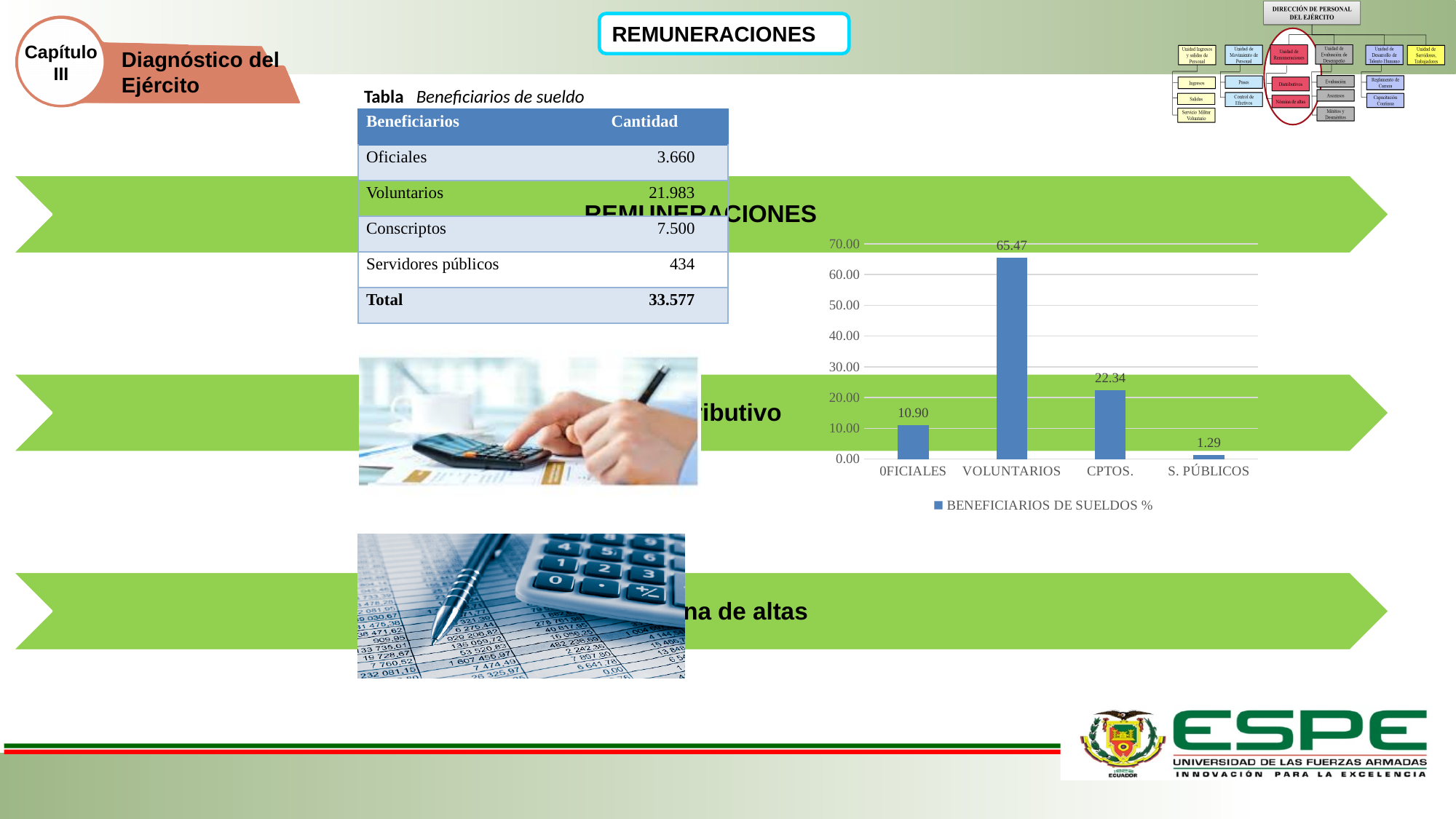
How many categories are shown on the x axis of the bar chart? 4 What kind of chart is shown on the slide? bar chart What is the value for VOLUNTARIOS in the bar chart? 65.47 What series name does the legend of the bar chart show? BENEFICIARIOS DE SUELDOS % Which is larger in the bar chart, the value for 0FICIALES or the value for CPTOS.? CPTOS. What is the value for CPTOS. in the bar chart? 22.34 Is the value for VOLUNTARIOS in the bar chart greater or less than 60.00? greater Which category has the highest value in the bar chart? VOLUNTARIOS What is the value for 0FICIALES in the bar chart? 10.90 Which category has the lowest value in the bar chart? S. PÚBLICOS What is the difference between the values for VOLUNTARIOS and CPTOS. in the bar chart? 43.13 What is the value for S. PÚBLICOS in the bar chart? 1.29